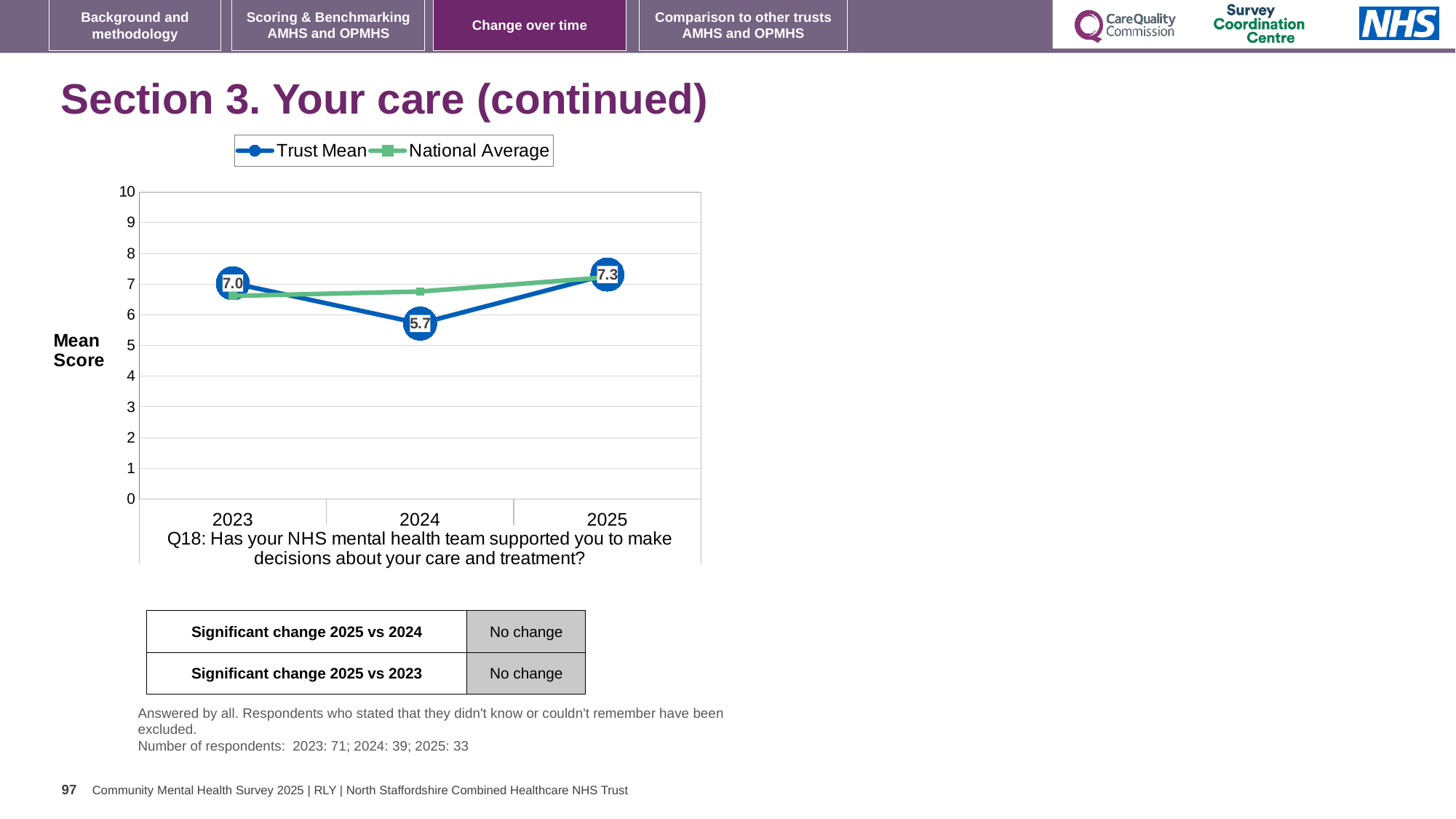
What kind of chart is shown on the slide? Line chart Does the Trust Mean rise or fall from 2024 to 2025? Rise Which is larger, the Trust Mean score for 2023 or for 2025? 2025 What is the Trust Mean score for 2023? 7.0 How many series does the legend list? 2 In which year is the Trust Mean score highest? 2025 What is the Trust Mean score for 2024? 5.7 How many years are plotted on the x axis? 3 What is the difference between the Trust Mean scores for 2025 and 2024? 1.6 What is the Trust Mean score for 2025? 7.3 Is the National Average value for 2023 greater or less than 6? greater In which year is the Trust Mean score lowest? 2024